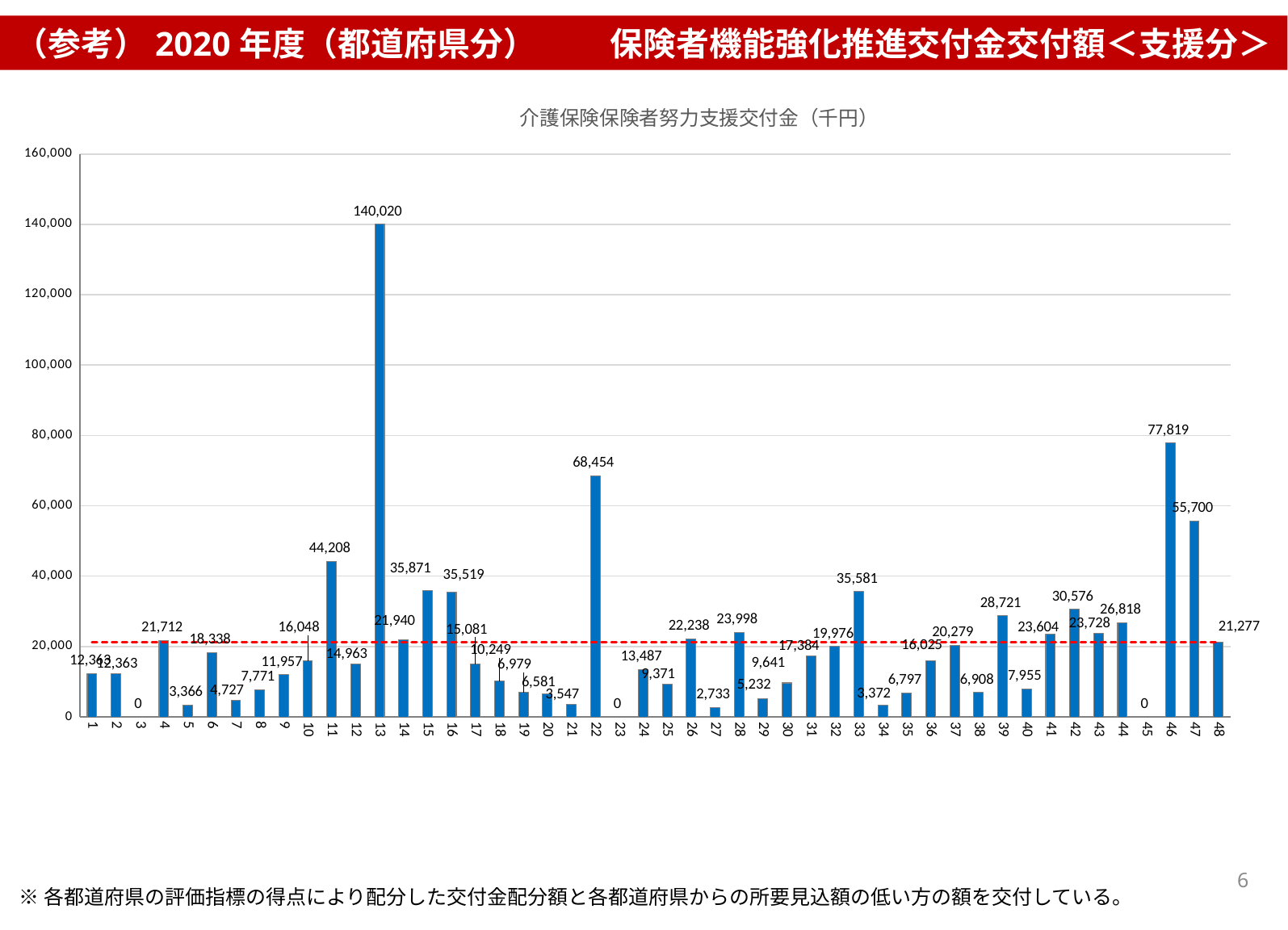
What is the difference between the values for category 13 and category 22? 71,566 What is the value for category 46? 77,819 Is the value for category 15 greater or less than 20,000? greater What is the value for category 13? 140,020 Which is larger, the value for category 46 or the value for category 22? 46 What is the value for category 22? 68,454 How many categories are plotted along the x axis? 48 What kind of chart is shown on the slide? bar chart What is the value for category 48? 21,277 What is the title of the chart? 介護保険保険者努力支援交付金（千円） What is the difference between the values for category 46 and category 47? 22,119 Which category has the highest value? 13